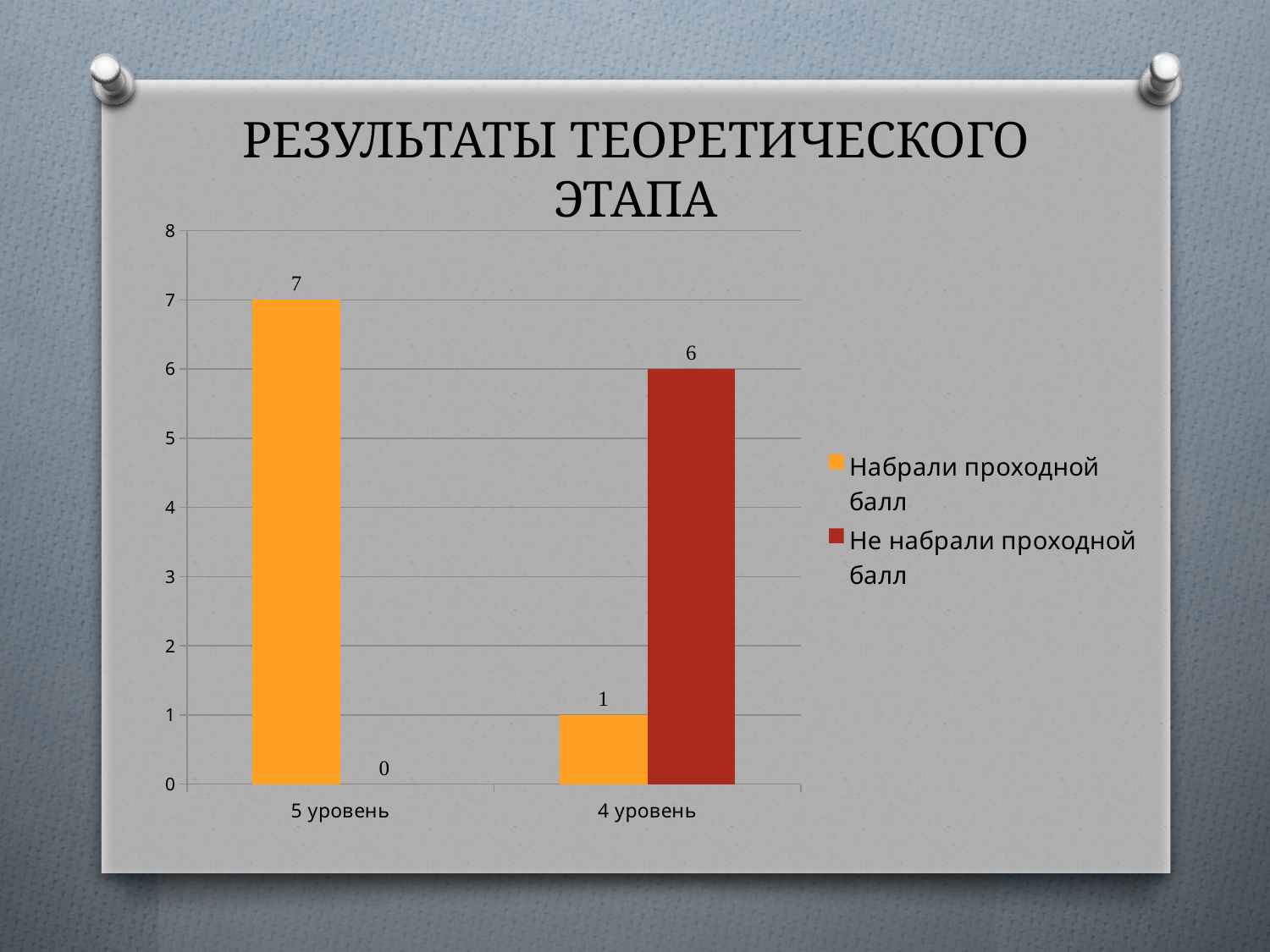
Which category has the lowest value for "Не набрали проходной балл"? 5 уровень At "4 уровень", which series is larger: "Набрали проходной балл" or "Не набрали проходной балл"? Не набрали проходной балл What is the difference between "Набрали проходной балл" at "5 уровень" and at "4 уровень"? 6 How many series does the legend list? 2 How many categories are shown on the x axis? 2 What is the value for "Не набрали проходной балл" at "4 уровень"? 6 What is the value for "Набрали проходной балл" at "5 уровень"? 7 What is the value for "Набрали проходной балл" at "4 уровень"? 1 What is the value for "Не набрали проходной балл" at "5 уровень"? 0 Which category has the highest value for "Набрали проходной балл"? 5 уровень What kind of chart is shown on the slide? Bar chart What is the title of the slide? РЕЗУЛЬТАТЫ ТЕОРЕТИЧЕСКОГО ЭТАПА